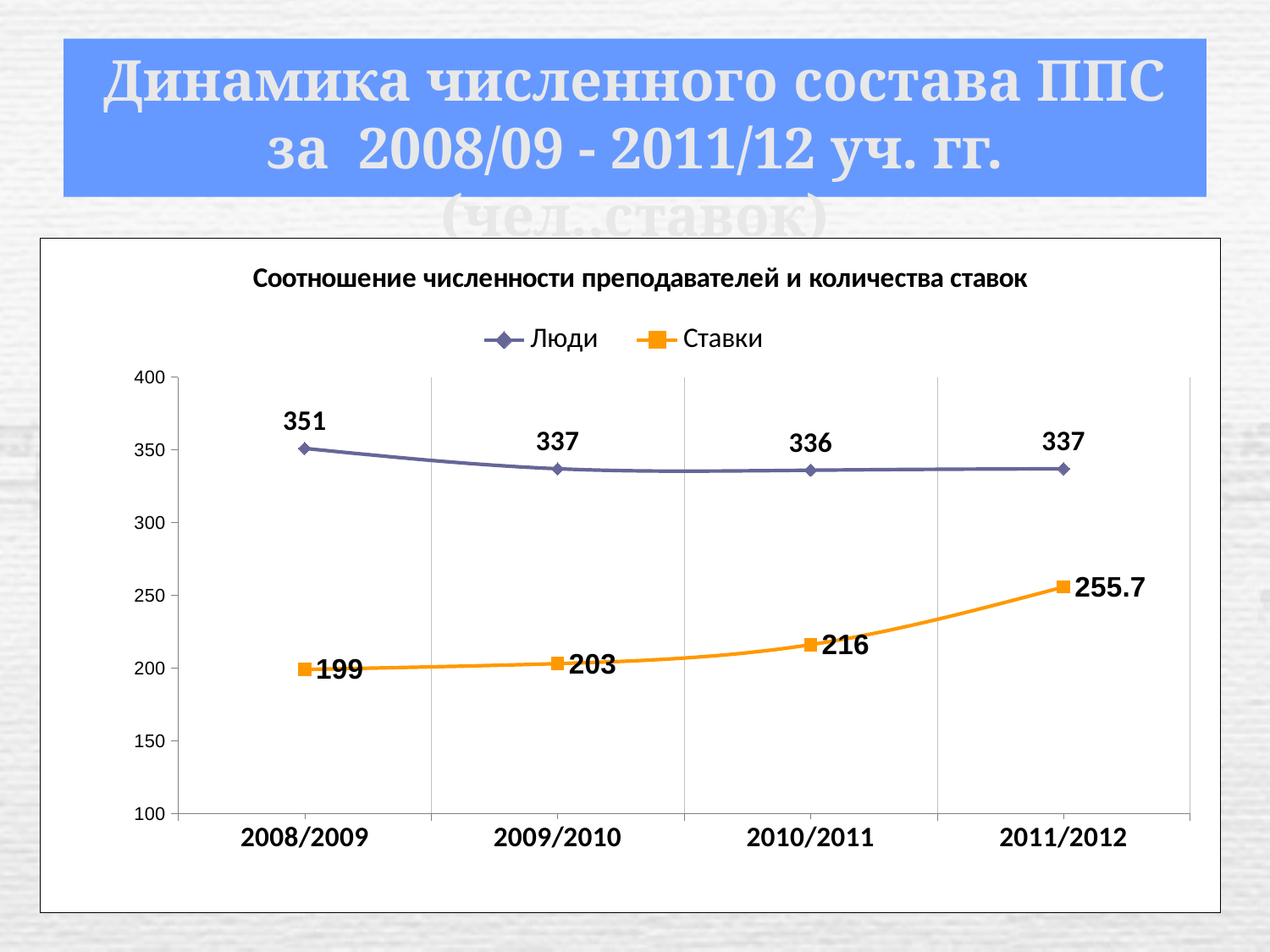
What is the difference between Люди and Ставки in 2008/2009? 152 In which year is the Люди series highest? 2008/2009 How many series does the legend list? 2 Which is larger in 2011/2012, Люди or Ставки? Люди What is the value for Люди in 2008/2009? 351 What kind of chart is shown? line chart In which year is the Ставки series lowest? 2008/2009 How many years are shown on the x axis? 4 By how much did Ставки increase from 2008/2009 to 2011/2012? 56.7 What is the value for Ставки in 2011/2012? 255.7 In which year is the Ставки series highest? 2011/2012 What is the value for Ставки in 2010/2011? 216